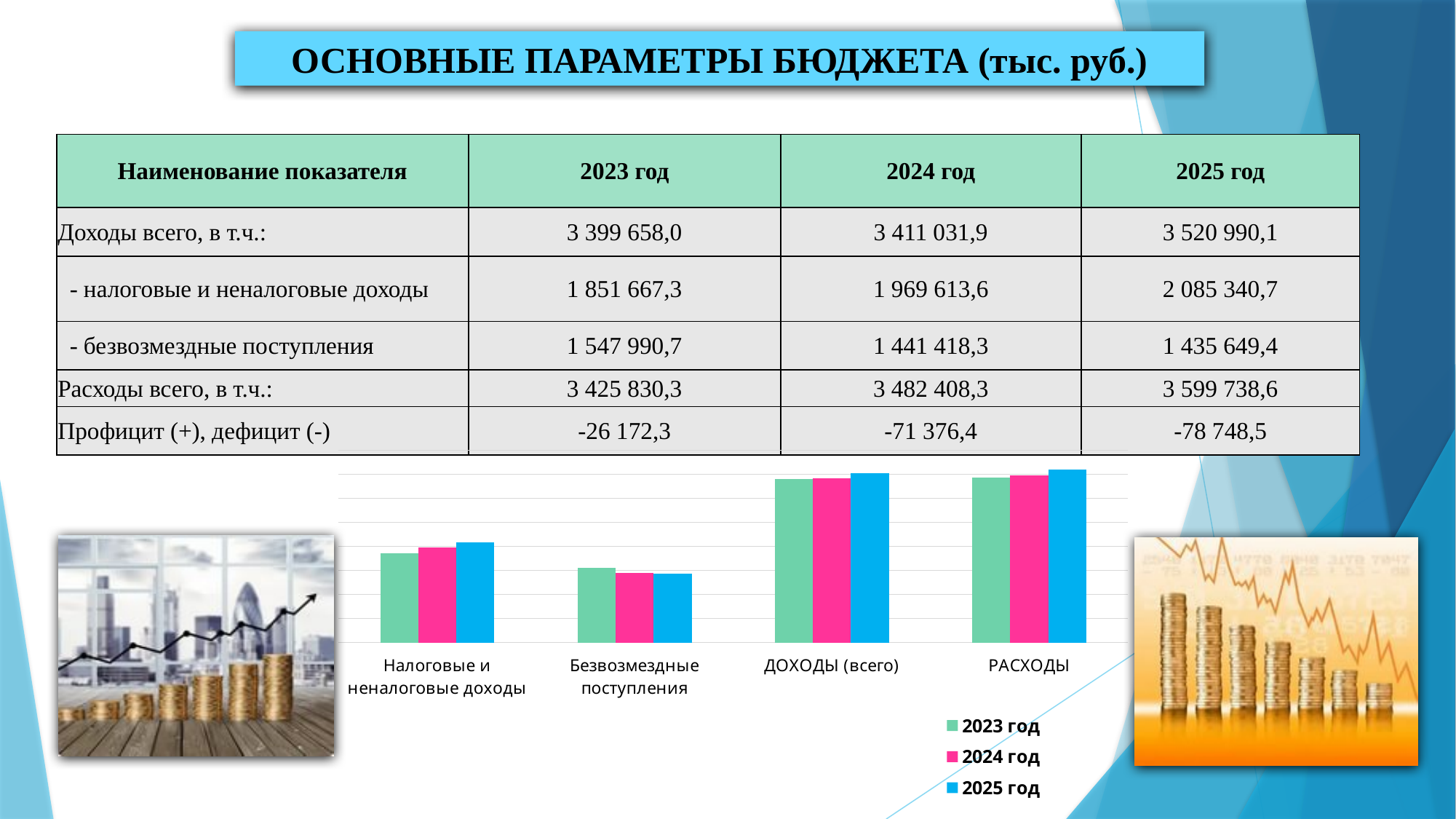
What kind of chart is shown at the bottom of the slide? Bar chart How many categories are shown on the x axis of the bar chart? 4 In the bar chart, do the bars for 'Налоговые и неналоговые доходы' rise or fall from 2023 год to 2025 год? Rise According to the slide, what is the difference between 'РАСХОДЫ' and 'ДОХОДЫ (всего)' for 2025 год? 78 748,5 Which category in the bar chart has the shortest bars overall? Безвозмездные поступления Which category in the bar chart has the tallest bars overall? РАСХОДЫ How many series does the legend of the bar chart list? 3 In the bar chart, do the bars for 'Безвозмездные поступления' rise or fall from 2023 год to 2025 год? Fall In the bar chart, which is larger for 2025 год: 'Налоговые и неналоговые доходы' or 'Безвозмездные поступления'? Налоговые и неналоговые доходы According to the slide, what is the value of 'ДОХОДЫ (всего)' for 2025 год? 3 520 990,1 Which colour represents the series '2024 год' in the bar chart? Pink According to the slide, what is the value of 'РАСХОДЫ' for 2023 год? 3 425 830,3